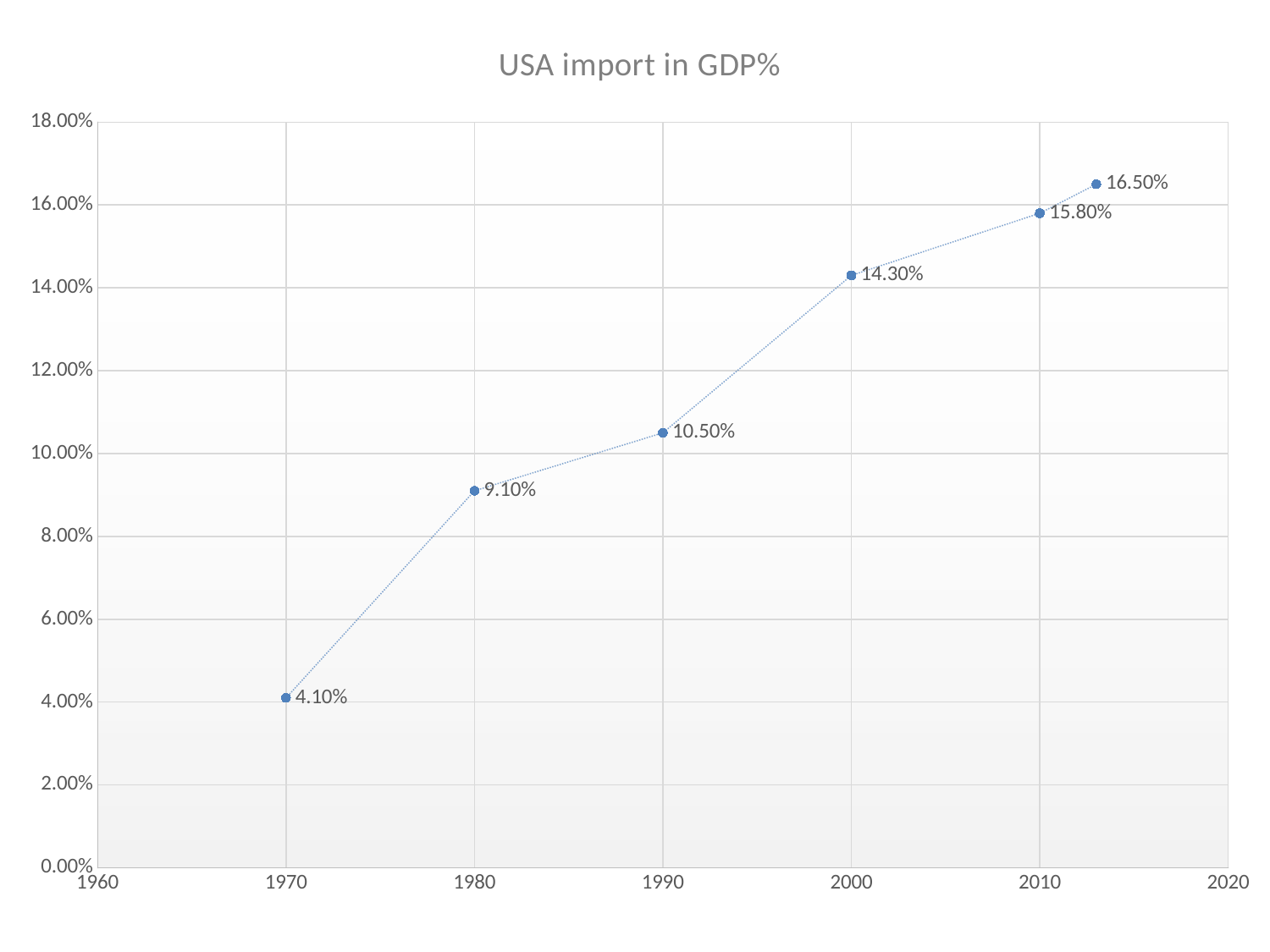
What is the value of the last (rightmost) data point? 16.50% What is the value for 1980? 9.10% What is the difference between the values for 2000 and 1990? 3.80% How many data points are plotted on the chart? 6 What is the title of the chart? USA import in GDP% Which year has the lowest value? 1970 What kind of chart is shown on the slide? line chart What is the value for 2010? 15.80% What is the value for 1990? 10.50% Do the values rise or fall from 1970 to the last data point? rise What is the value for 1970? 4.10% What is the value for 2000? 14.30%